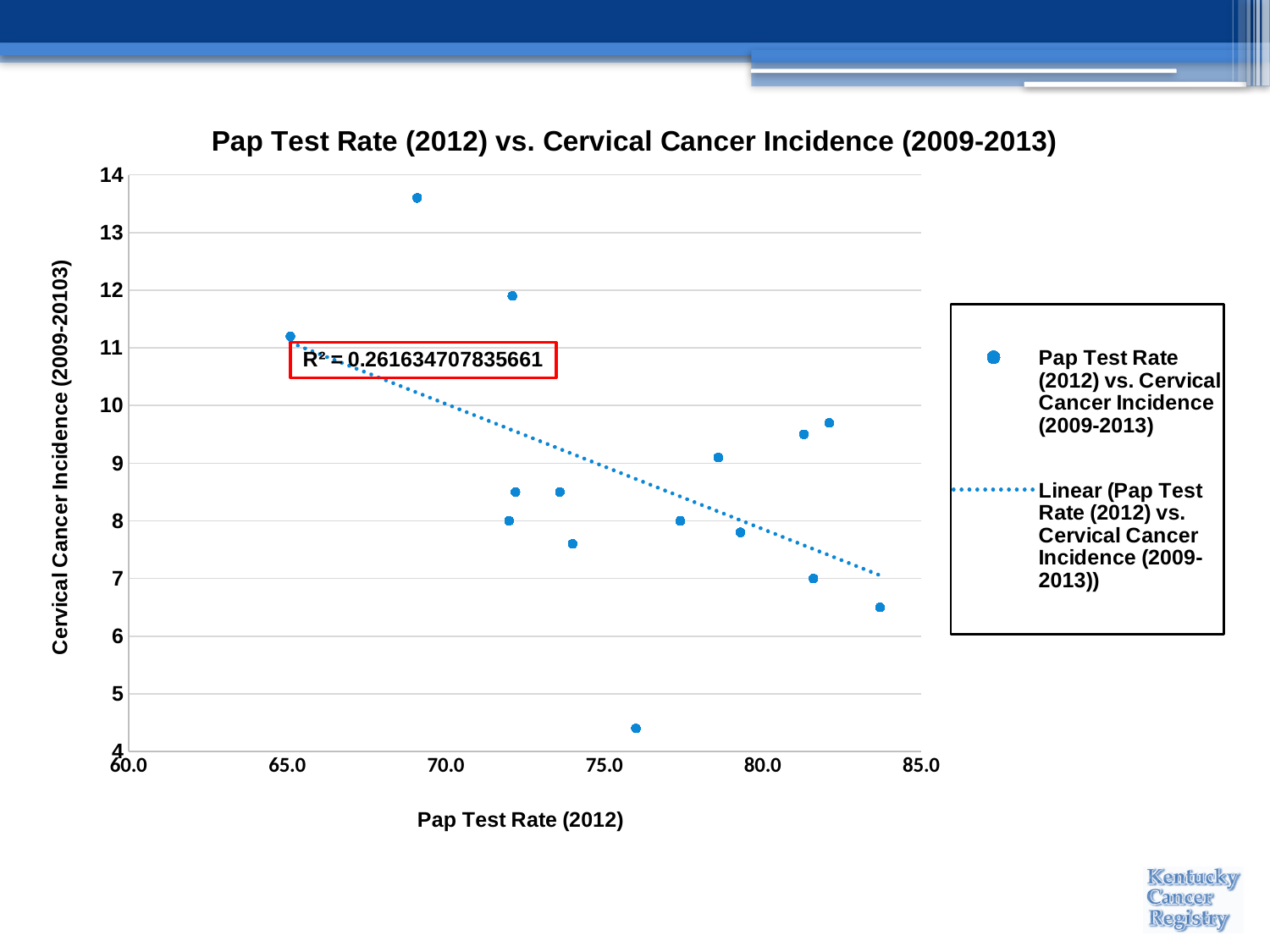
What kind of chart is shown on the slide? Scatter chart Does the dotted trend line rise or fall as the Pap Test Rate increases? Fall How many data points are plotted on the chart? 15 Which has the higher cervical cancer incidence: the point at a Pap Test Rate of about 69 or the point at about 76? The point at about 69 What is the title of the chart? Pap Test Rate (2012) vs. Cervical Cancer Incidence (2009-2013) Is the cervical cancer incidence of the highest plotted point greater or less than 13? greater How many entries does the legend list? 2 Is the cervical cancer incidence of the point with the lowest Pap Test Rate (near 65) greater or less than 11? greater Is the cervical cancer incidence of the lowest plotted point greater or less than 5? less What R² value is printed on the chart? R² = 0.261634707835661 What is the label of the x axis? Pap Test Rate (2012)